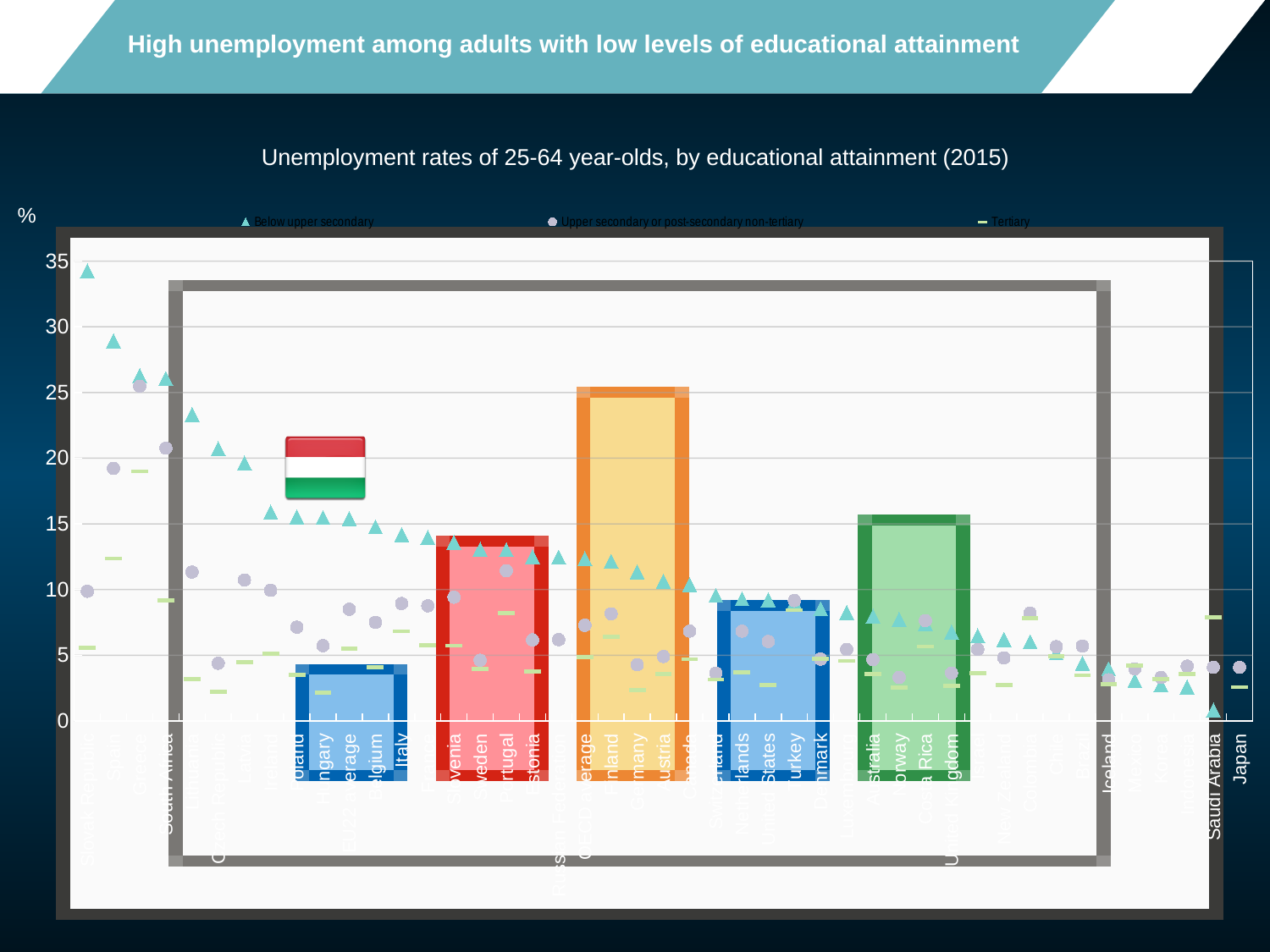
Which series is shown with triangle markers? Below upper secondary How many series does the chart legend list? 3 Which country has the highest 'Below upper secondary' unemployment rate? Slovak Republic Which has the larger 'Upper secondary or post-secondary non-tertiary' value, Greece or Spain? Greece Is the 'Below upper secondary' value for Spain greater or less than 25? greater Is the 'Below upper secondary' value for the Slovak Republic greater or less than 30? greater Do the 'Below upper secondary' values generally rise or fall from left to right across the countries? fall Is the 'Upper secondary or post-secondary non-tertiary' value for Greece greater or less than 20? greater What is the title of the chart? Unemployment rates of 25-64 year-olds, by educational attainment (2015)